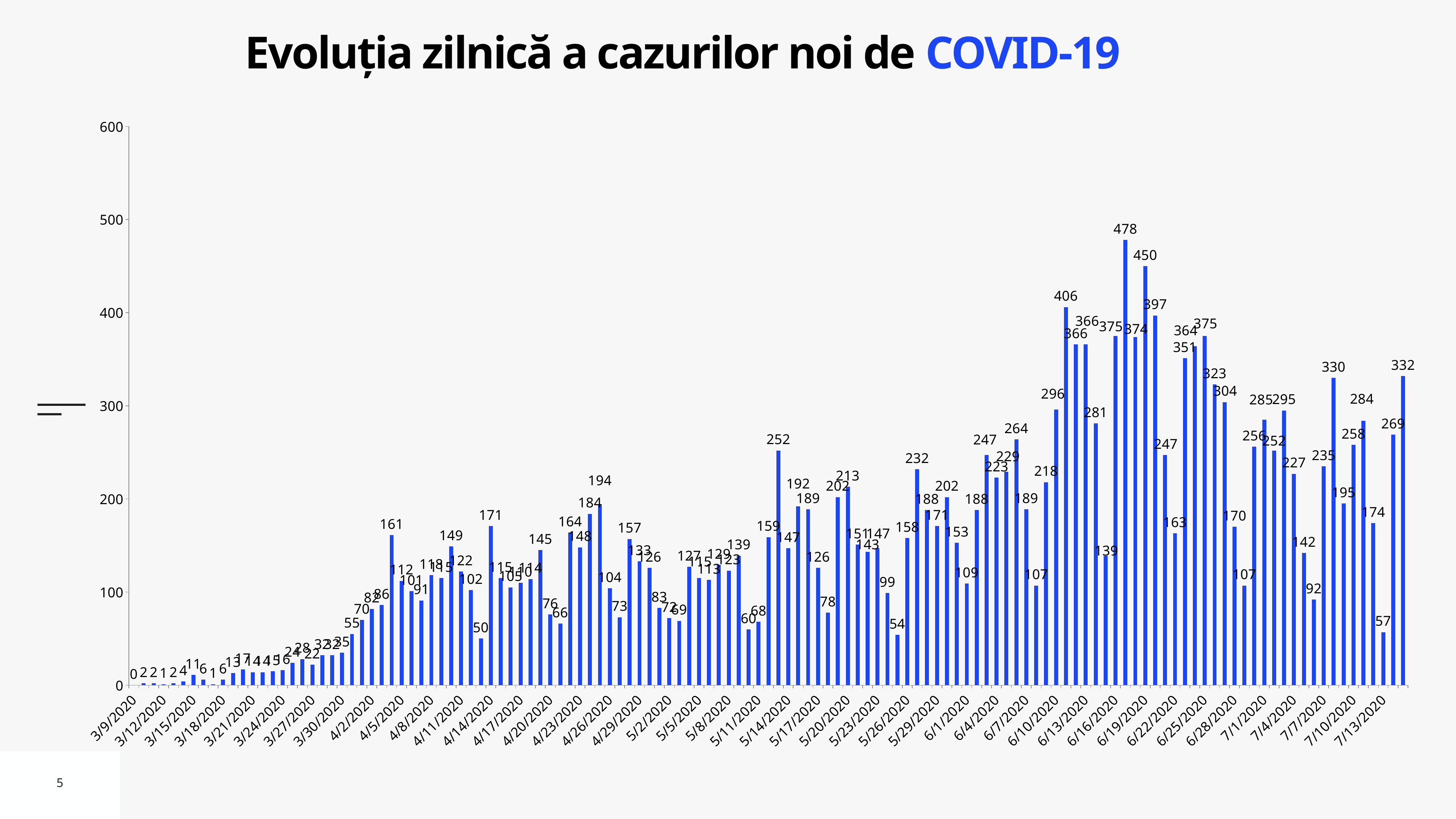
Is the value of the last bar in the chart greater or less than 300? greater Is the value of the bar for 3/9/2020 greater or less than 100? less What is the difference between the two highest values, 478 and 450? 28 What is the highest daily value shown in the chart? 478 What is the lowest daily value shown in the chart? 0 Overall, do the daily values rise or fall from March to July along the x axis? rise What is the difference between the bar labelled 252 in mid-May and the bar labelled 54 in late May? 198 What is the maximum value shown on the vertical axis? 600 What is the value of the first bar, for 3/9/2020? 0 Which is larger, the bar labelled 406 or the bar labelled 397? 406 What is the title of the chart? Evoluția zilnică a cazurilor noi de COVID-19 What type of chart is shown on the slide? bar chart